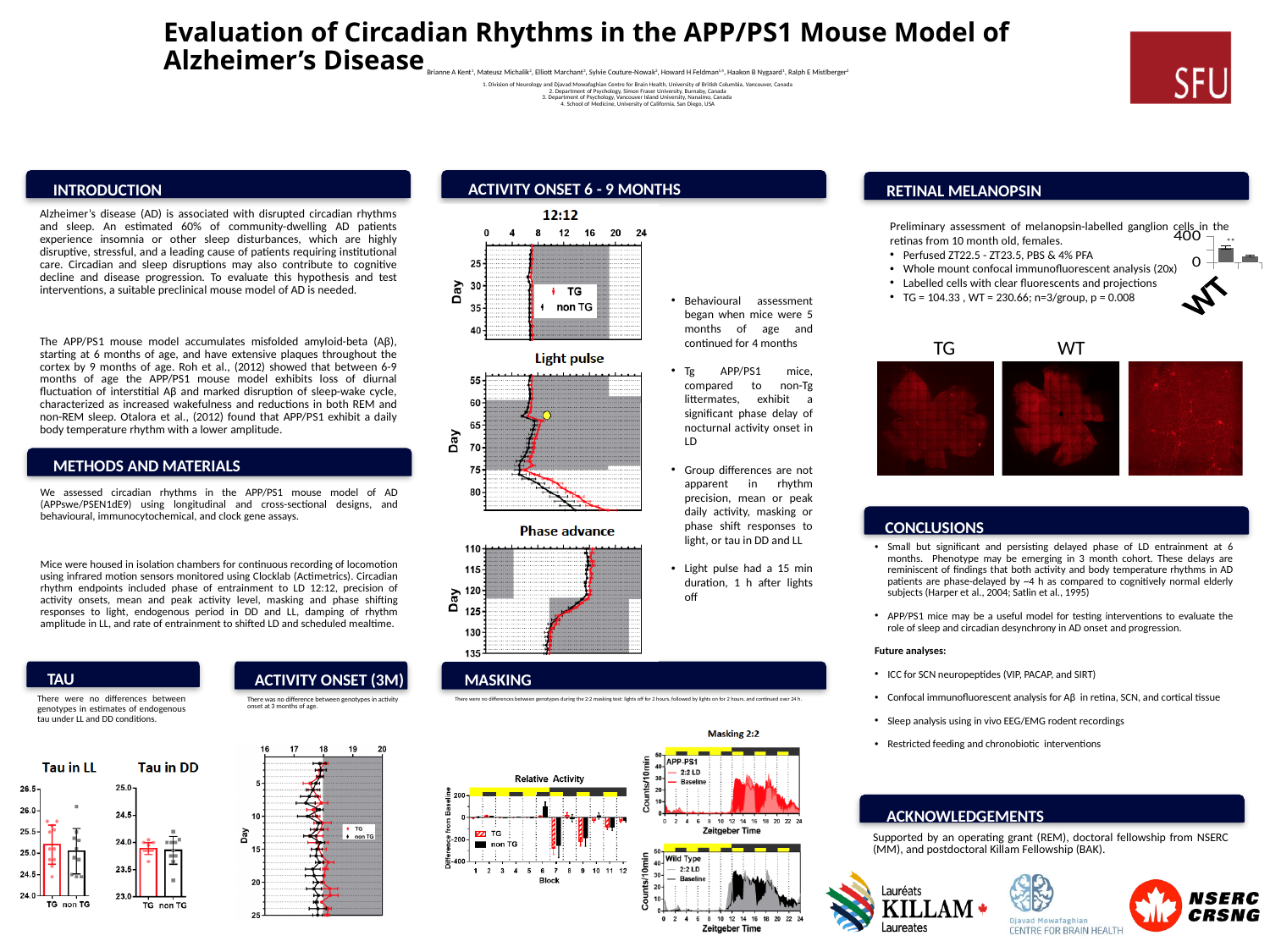
In the 12:12 actogram under Activity Onset 6-9 Months, what colour represents the TG group in the legend? Red In the 12:12 actogram under Activity Onset 6-9 Months, how many series does the legend list? 2 In the Retinal Melanopsin bar chart, what is the value reported for TG? 104.33 What kind of chart is the Relative Activity chart in the Masking section? Bar chart In the Relative Activity chart in the Masking section, how many blocks are shown on the x axis? 12 What are the titles of the two tau charts in the TAU section? Tau in LL and Tau in DD In the Retinal Melanopsin bar chart, is the value for WT greater or less than 200? greater In the Retinal Melanopsin bar chart, what is the value reported for WT? 230.66 In the Masking 2:2 charts, how many series does the legend of the APP-PS1 panel list? 2 In the Retinal Melanopsin bar chart, which group has the higher value, TG or WT? WT In the Relative Activity chart in the Masking section, is the TG value at block 7 greater or less than 0? less In the Retinal Melanopsin bar chart, what is the difference between the WT and TG values? 126.33